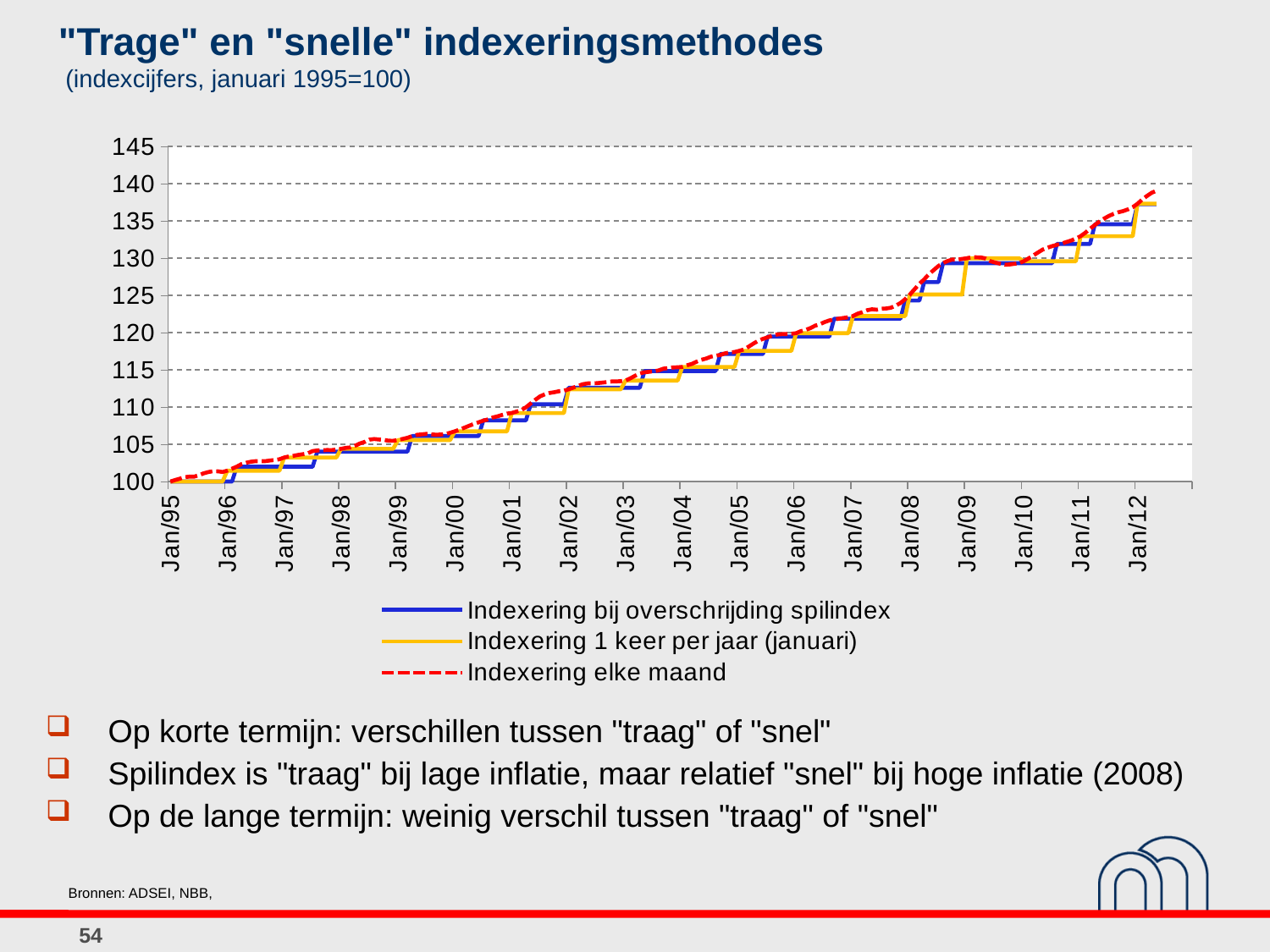
Which series is drawn as a red dashed line? Indexering elke maand Is the value of 'Indexering elke maand' at Jan/12 greater or less than 135? greater Is the value of 'Indexering bij overschrijding spilindex' at Jan/05 greater or less than 115? greater What is the base value of the index series in Jan/95? 100 What is the highest value shown on the y axis? 145 Do the index values rise or fall from Jan/95 to Jan/12? rise Is the value of 'Indexering elke maand' at Jan/02 greater or less than 110? greater How many series does the legend list? 3 How many year labels are shown on the x axis? 18 What kind of chart is shown on the slide? line chart